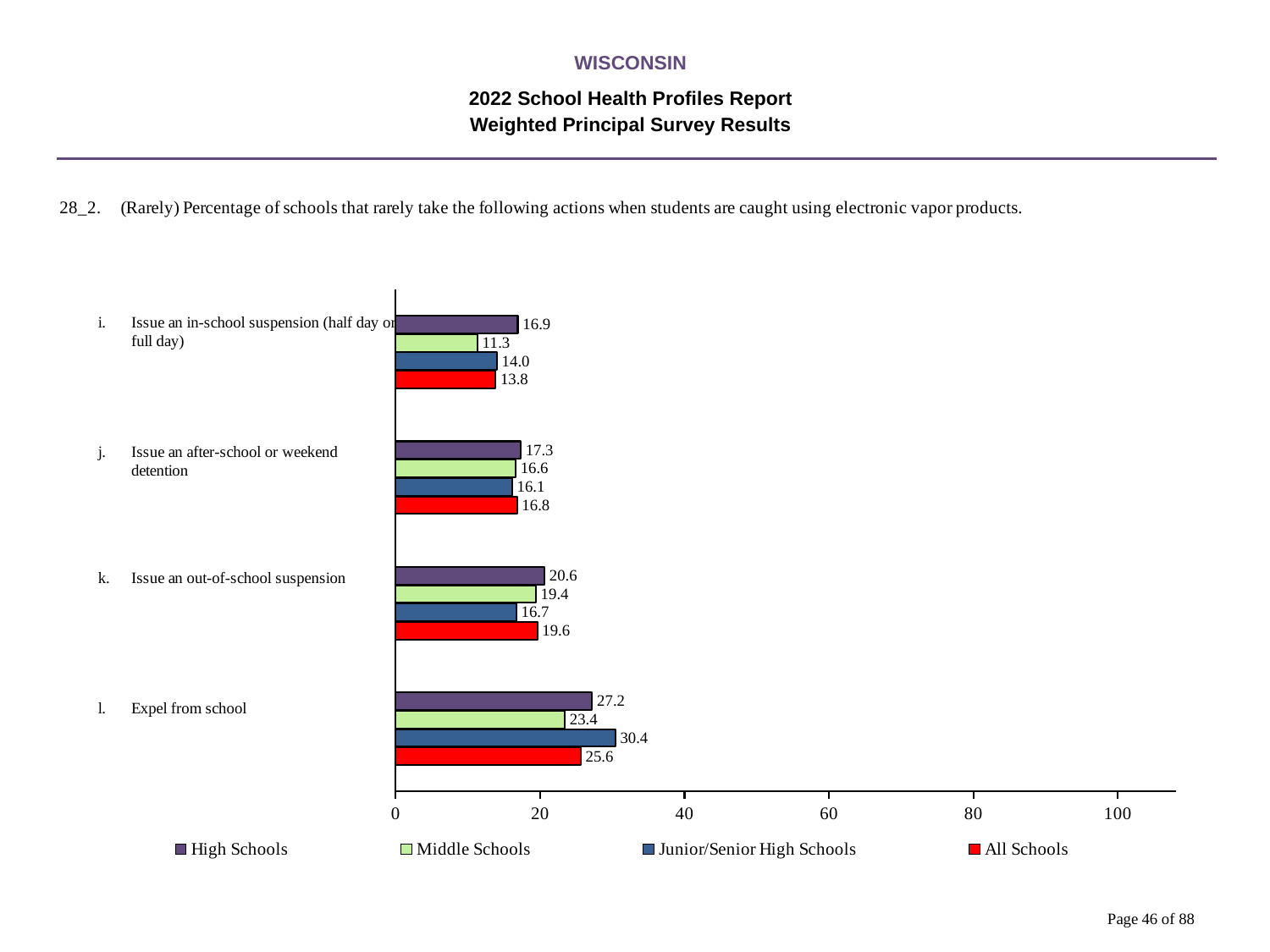
What is the value for High Schools for 'Expel from school'? 27.2 What is the difference between the Junior/Senior High Schools and Middle Schools values for 'Expel from school'? 7.0 Which is larger for 'Issue an out-of-school suspension': High Schools or Junior/Senior High Schools? High Schools What is the value for All Schools for 'Issue an out-of-school suspension'? 19.6 What is the value for Middle Schools for 'Issue an in-school suspension (half day or full day)'? 11.3 Which category has the lowest value for Middle Schools? Issue an in-school suspension (half day or full day) How many categories (actions) are shown in the chart? 4 Which category has the highest value for Junior/Senior High Schools? Expel from school Is the value for Junior/Senior High Schools for 'Expel from school' greater or less than 20? greater What is the value for Junior/Senior High Schools for 'Issue an after-school or weekend detention'? 16.1 How many series does the legend list? 4 What kind of chart is shown on the slide? Bar chart